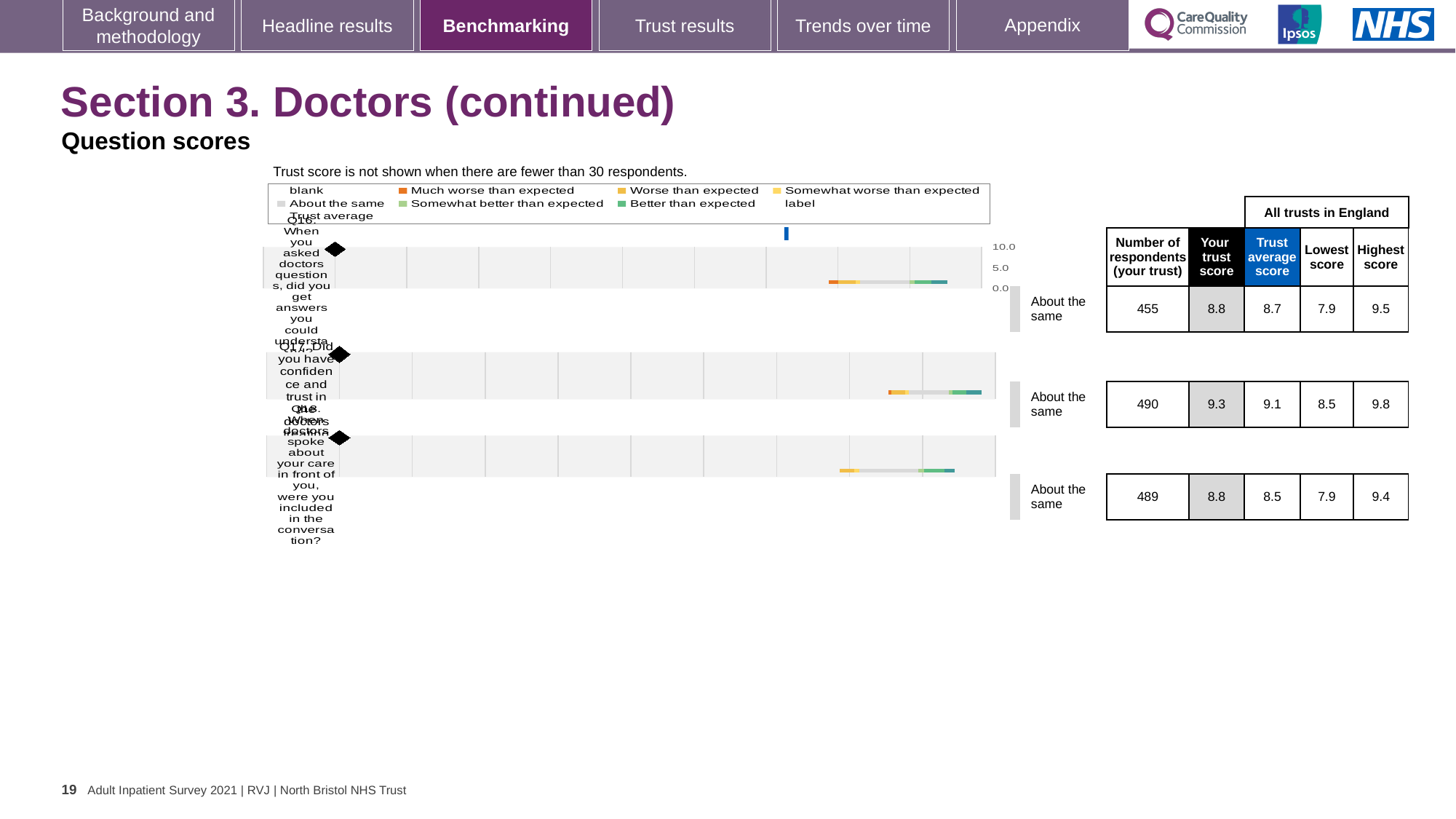
What benchmark category is shown for Q18? About the same Which question has the lowest highest score across all trusts in England? Q18 What is the lowest score across all trusts in England for Q17? 8.5 What is the trust average score for Q18 (When doctors spoke about your care in front of you, were you included in the conversation)? 8.5 How many questions are plotted in the chart? 3 For Q18, how much higher is the trust's score than the trust average score? 0.3 For Q16, which is larger: the trust's score or the trust average score? Your trust score (8.8) What kind of chart is used to show the question scores? Bar chart How many respondents from the trust answered Q16 (When you asked doctors questions, did you get answers you could understand)? 455 What is the difference between the highest score and the lowest score for Q17? 1.3 What is the 'Your trust score' for Q17 (Did you have confidence and trust in the doctors treating you)? 9.3 Which question has the highest 'Your trust score'? Q17